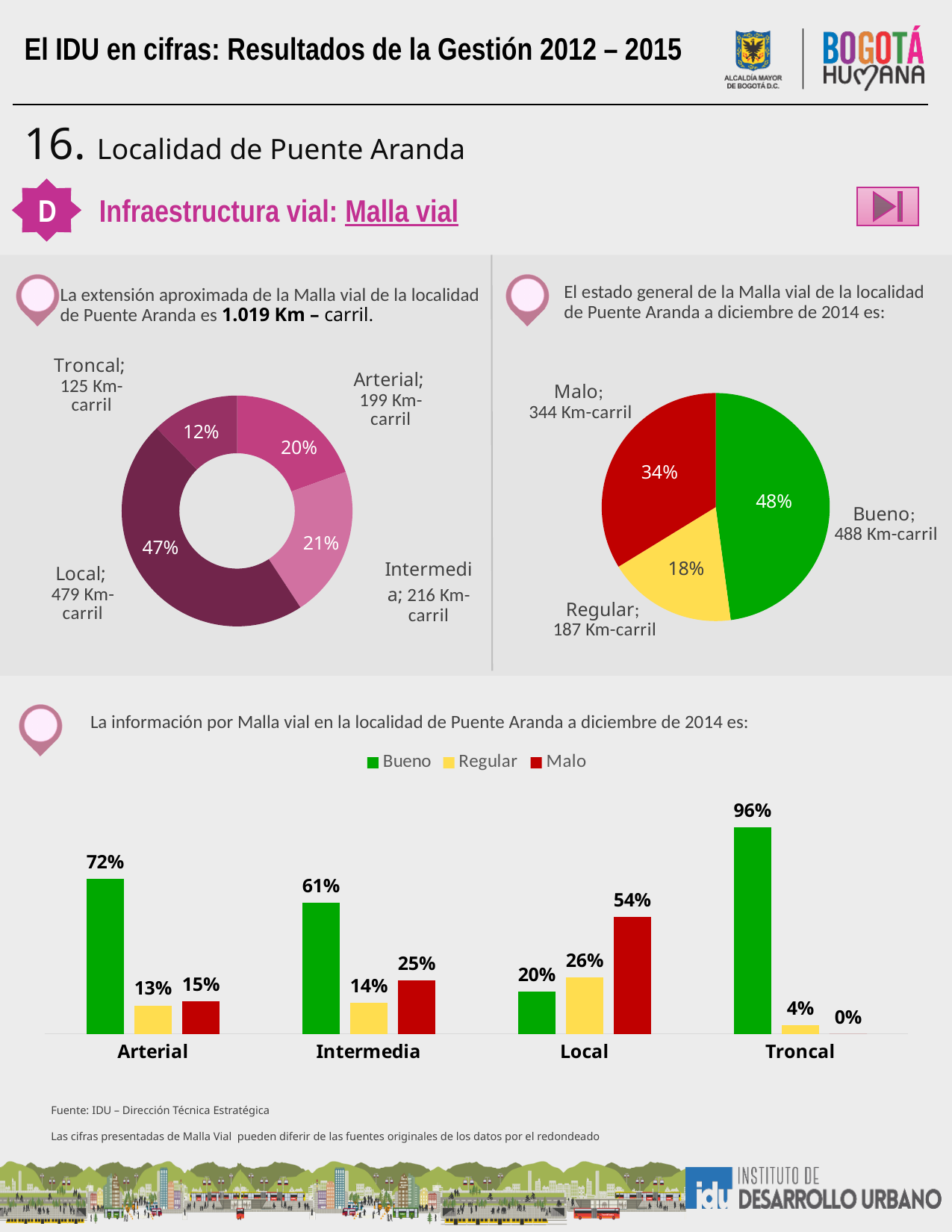
In the bottom bar chart, how many series does the legend list? 3 In the left donut chart, which category has the smallest share? Troncal In the bottom bar chart, which is larger for Local: Regular or Bueno? Regular In the right pie chart, what percentage of the road network is in Malo condition? 34% In the bottom bar chart, what is the difference between the Bueno values for Arterial and Intermedia? 11% In the bottom bar chart, what is the Malo value for Local? 54% In the right pie chart, how many Km-carril are in Bueno condition? 488 Km-carril In the left donut chart, how many Km-carril does the Arterial category have? 199 Km-carril In the left donut chart, what share of the road network is Local? 47% In the right pie chart, which condition has the largest share? Bueno In the bottom bar chart, what is the Bueno value for Troncal? 96% In the left donut chart, how many categories are shown? 4